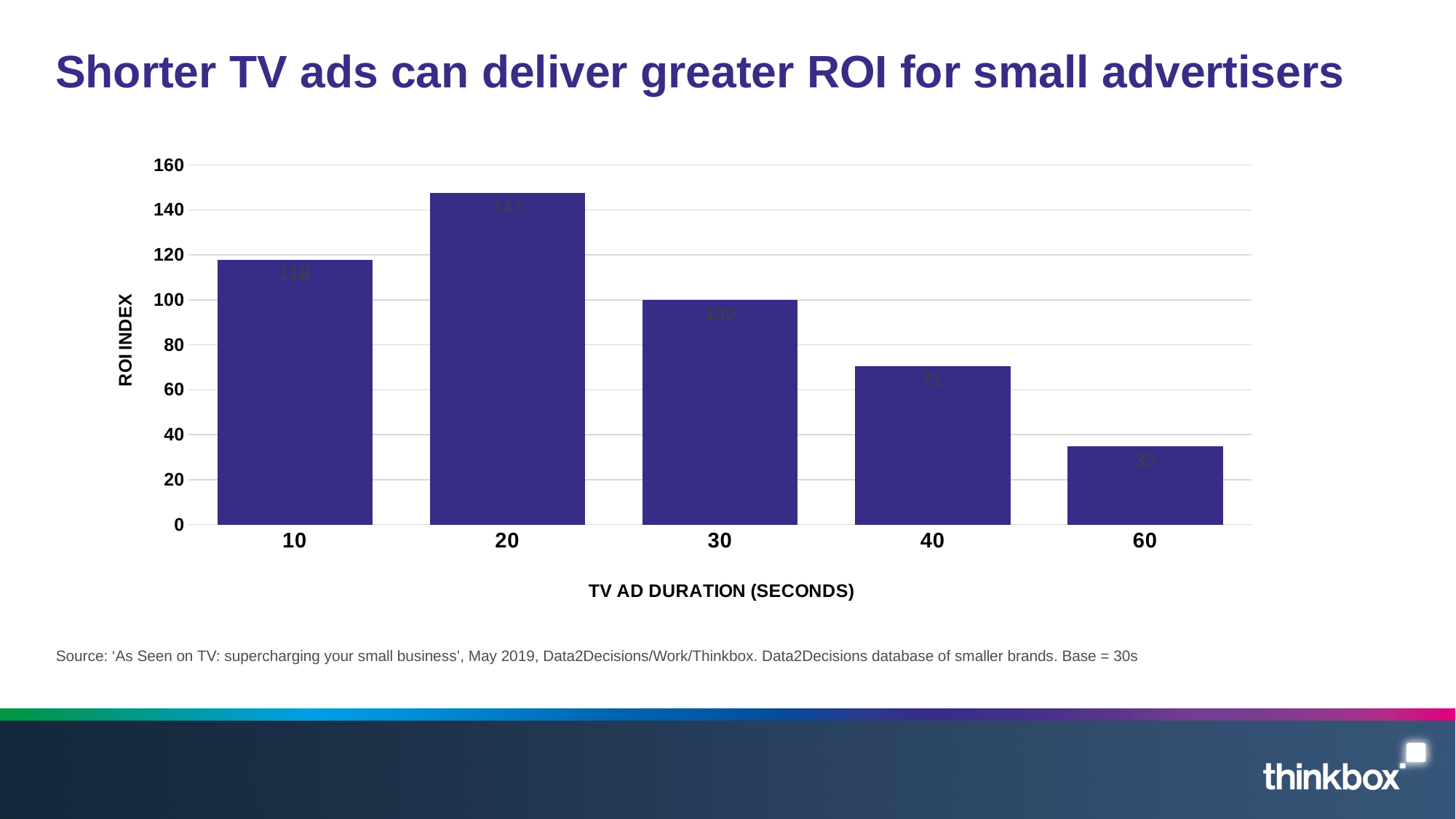
How many TV ad durations are shown on the chart? 5 Which TV ad duration has the lowest ROI index? 60 Is the ROI index for the 40-second ad greater or less than 80? less What is the ROI index for a 10-second TV ad? 118 What is the difference in ROI index between the 20-second and 30-second ads? 47 Which has a higher ROI index, the 10-second ad or the 40-second ad? 10 What is the label of the vertical axis? ROI INDEX What is the ROI index for a 20-second TV ad? 147 From the 20-second ad onwards, does the ROI index rise or fall as ad duration increases? fall What kind of chart is shown on the slide? bar chart What is the ROI index for a 60-second TV ad? 35 Which TV ad duration has the highest ROI index? 20